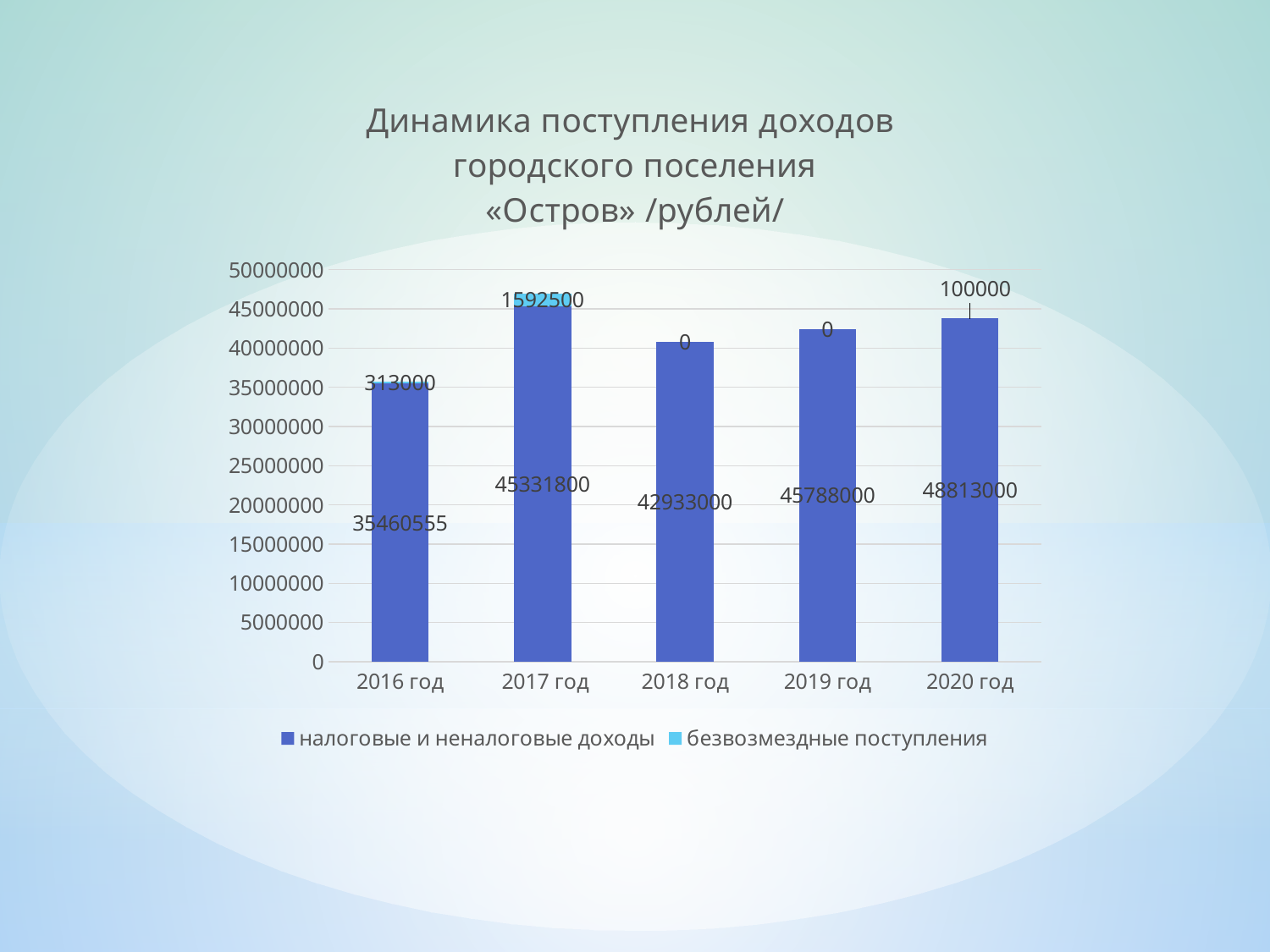
What is the value of налоговые и неналоговые доходы for 2020 год? 48813000 How many years are shown on the x axis? 5 Which is larger: безвозмездные поступления in 2017 год or in 2020 год? 2017 год What kind of chart is shown on the slide? Bar chart What is the value of налоговые и неналоговые доходы for 2016 год? 35460555 Which year has the lowest value of налоговые и неналоговые доходы? 2016 год What is the value of безвозмездные поступления for 2018 год? 0 What is the value of безвозмездные поступления for 2017 год? 1592500 What is the difference between налоговые и неналоговые доходы in 2020 год and 2016 год? 13352445 What is the total of the stacked bar for 2017 год? 46924300 How many series does the legend list? 2